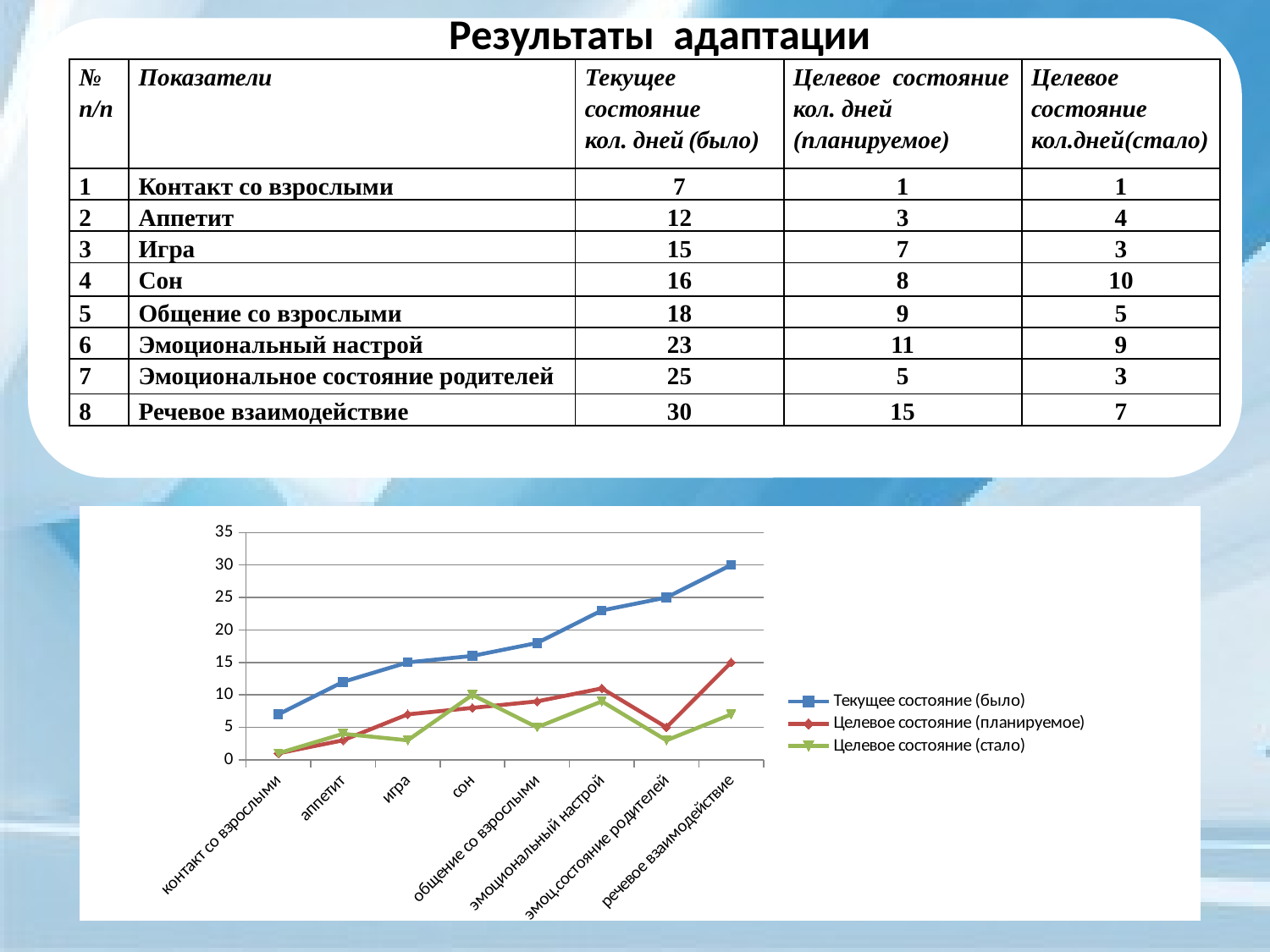
For 'речевое взаимодействие', which is larger: 'Целевое состояние (планируемое)' or 'Целевое состояние (стало)'? Целевое состояние (планируемое) How many series does the chart legend list? 3 What is the value of the 'Целевое состояние (планируемое)' series for 'речевое взаимодействие'? 15 What kind of chart is shown on the slide? line chart Does the 'Текущее состояние (было)' series rise or fall along the x axis? rise What is the difference between the 'Текущее состояние (было)' and 'Целевое состояние (планируемое)' values for 'речевое взаимодействие'? 15 What is the value of the 'Текущее состояние (было)' series for 'речевое взаимодействие'? 30 What is the value of the 'Целевое состояние (стало)' series for 'сон'? 10 Is the value of 'Текущее состояние (было)' for 'эмоциональный настрой' greater or less than 20? greater Which category has the highest value in the 'Текущее состояние (было)' series? речевое взаимодействие Which category has the lowest value in the 'Текущее состояние (было)' series? контакт со взрослыми How many categories are plotted along the x axis of the chart? 8